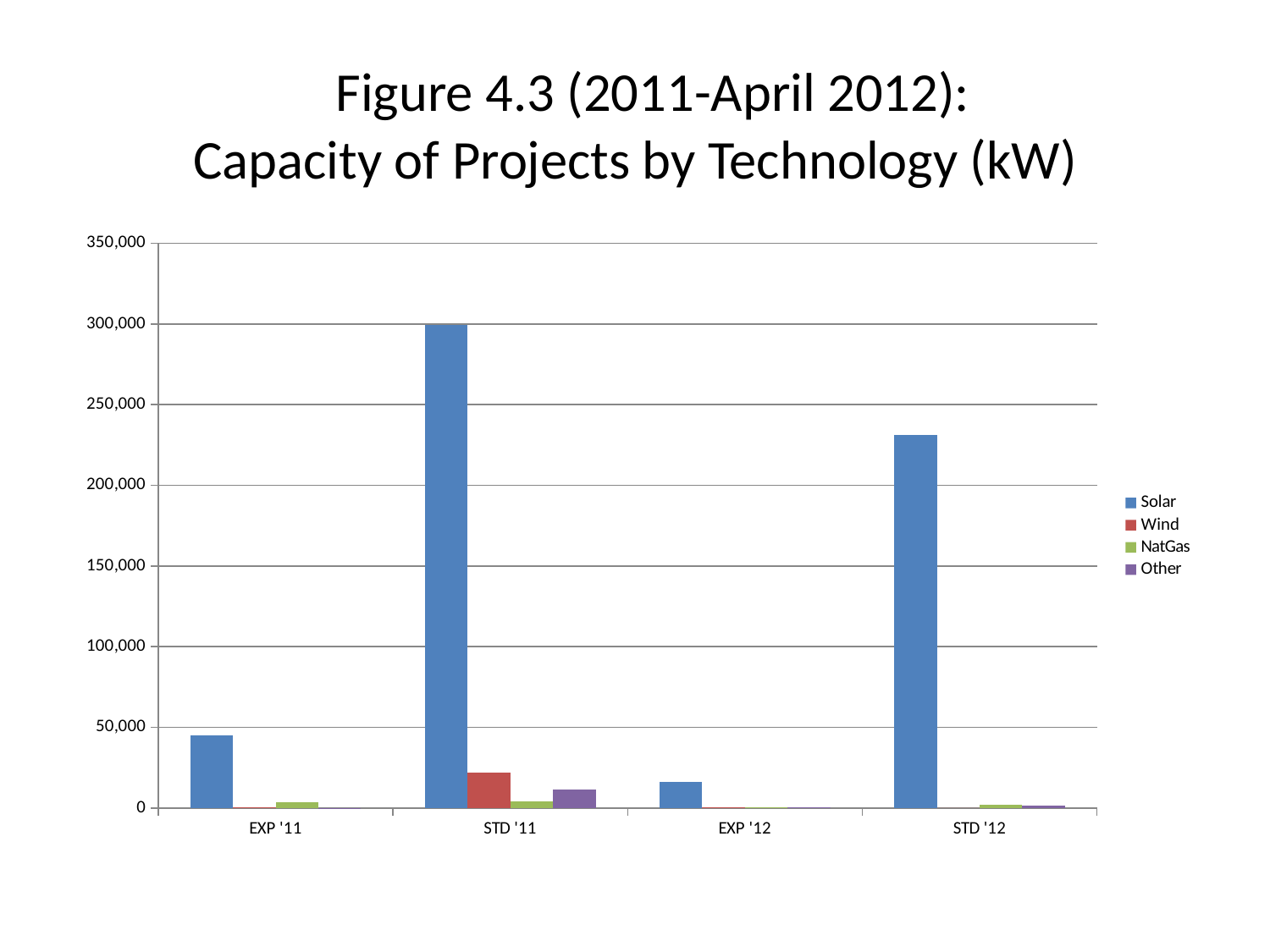
How many series does the legend list? 4 Which is larger, the Wind value for STD '11 or the Other value for STD '11? Wind Is the Solar value for STD '12 greater or less than 200,000? greater What unit is given in the chart title for the capacity values? kW Is the Solar value for STD '11 greater or less than 250,000? greater How many categories are shown on the x axis? 4 Which category has the lowest Solar value? EXP '12 Which is larger, the Solar value for STD '11 or the Solar value for STD '12? STD '11 Is the Solar value for EXP '11 greater or less than 50,000? less Which category has the highest Solar value? STD '11 Which series is shown in blue in the legend? Solar What kind of chart is shown on the slide? bar chart